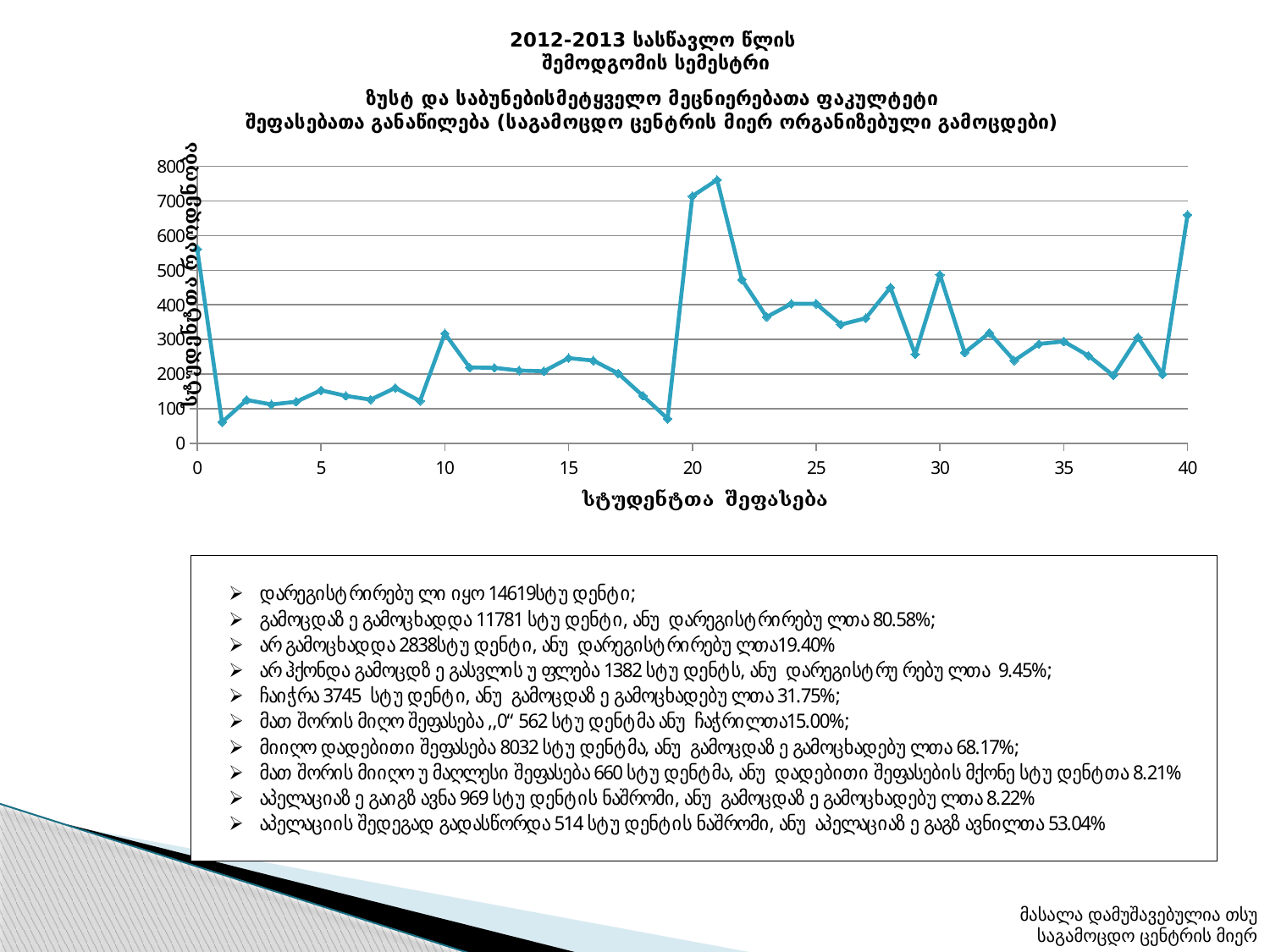
Is the value at x = 5 greater or less than 200? less What kind of chart is shown on the slide? line chart Is the value at x = 21 greater or less than 700? greater At which x-axis value (student evaluation score) does the line reach its highest point? 21 What is the label of the x axis? სტუდენტთა შეფასება Is the value at x = 19 greater or less than 100? less Which has the larger value, x = 10 or x = 20? 20 Does the line rise or fall between x = 21 and x = 23? fall Which has the larger value, x = 21 or x = 30? 21